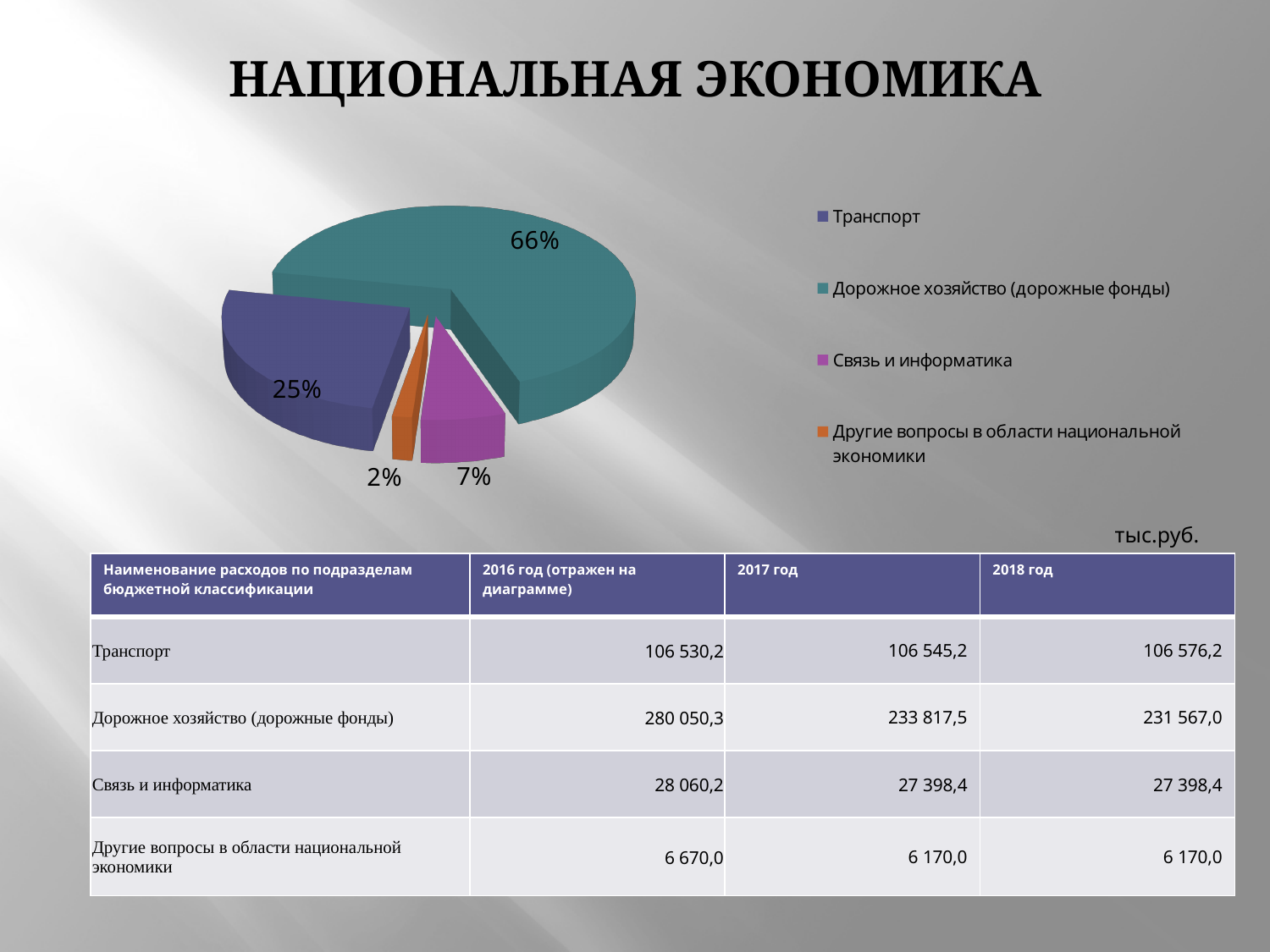
What share of the pie chart does Связь и информатика represent? 7% Which category has the smallest slice in the pie chart? Другие вопросы в области национальной экономики How many slices does the pie chart have? 4 What colour is the Связь и информатика slice in the pie chart? Purple Which category has the largest slice in the pie chart? Дорожное хозяйство (дорожные фонды) What is the difference in percentage points between the Дорожное хозяйство (дорожные фонды) slice and the Транспорт slice? 41 How many entries does the legend of the pie chart list? 4 What share of the pie chart does Дорожное хозяйство (дорожные фонды) represent? 66% What share of the pie chart does Транспорт represent? 25% What type of chart is shown on the slide? Pie chart Which slice is larger in the pie chart: Транспорт or Связь и информатика? Транспорт